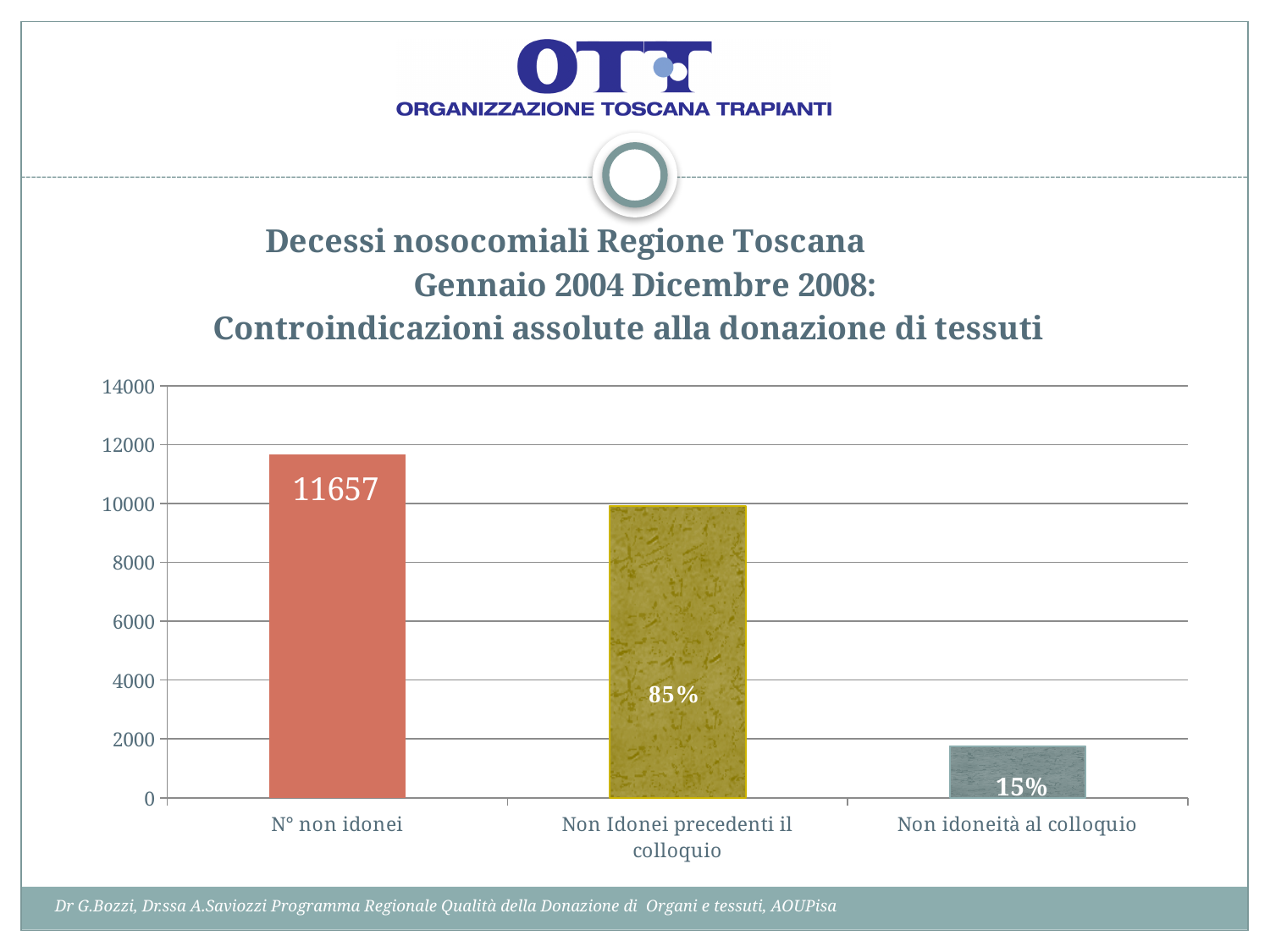
What kind of chart is shown on the slide? Bar chart Is the value for Non idoneità al colloquio greater or less than 2000? less Do the bar values rise or fall from left to right along the x axis? Fall What value is printed on the bar for N° non idonei? 11657 What label is printed on the bar for Non idoneità al colloquio? 15% What label is printed on the bar for Non Idonei precedenti il colloquio? 85% Which category has the tallest bar? N° non idonei Which bar is taller: N° non idonei or Non Idonei precedenti il colloquio? N° non idonei What is the highest value shown on the y axis? 14000 Which category has the shortest bar? Non idoneità al colloquio Is the value for Non Idonei precedenti il colloquio greater or less than 8000? greater How many categories are shown on the x axis? 3